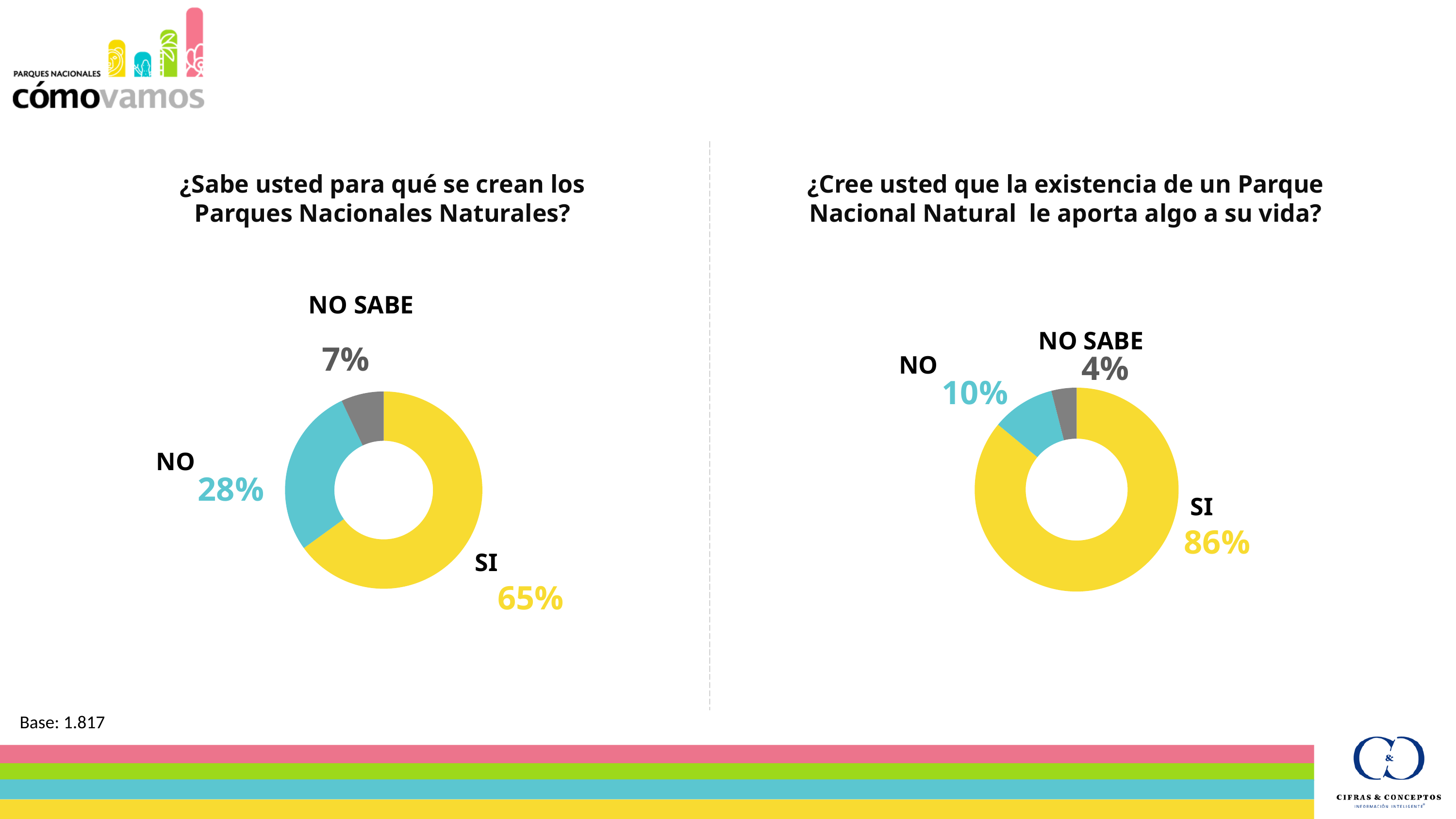
In the left chart (¿Sabe usted para qué se crean los Parques Nacionales Naturales?), what percentage answered SI? 65% In the left chart (¿Sabe usted para qué se crean los Parques Nacionales Naturales?), which response has the largest share? SI In the right chart (¿Cree usted que la existencia de un Parque Nacional Natural le aporta algo a su vida?), which response has the smallest share? NO SABE Which chart has the larger SI share, the left chart or the right chart? The right chart In the left chart (¿Sabe usted para qué se crean los Parques Nacionales Naturales?), what percentage is NO SABE? 7% In the left chart (¿Sabe usted para qué se crean los Parques Nacionales Naturales?), what percentage answered NO? 28% How many response categories does the right chart (¿Cree usted que la existencia de un Parque Nacional Natural le aporta algo a su vida?) show? 3 What type of chart is used on the left side of the slide? Donut (pie) chart In the left chart (¿Sabe usted para qué se crean los Parques Nacionales Naturales?), what is the difference between the SI and NO percentages? 37% In the right chart (¿Cree usted que la existencia de un Parque Nacional Natural le aporta algo a su vida?), what percentage is NO SABE? 4% In the right chart (¿Cree usted que la existencia de un Parque Nacional Natural le aporta algo a su vida?), what percentage answered SI? 86% In the right chart (¿Cree usted que la existencia de un Parque Nacional Natural le aporta algo a su vida?), what percentage answered NO? 10%